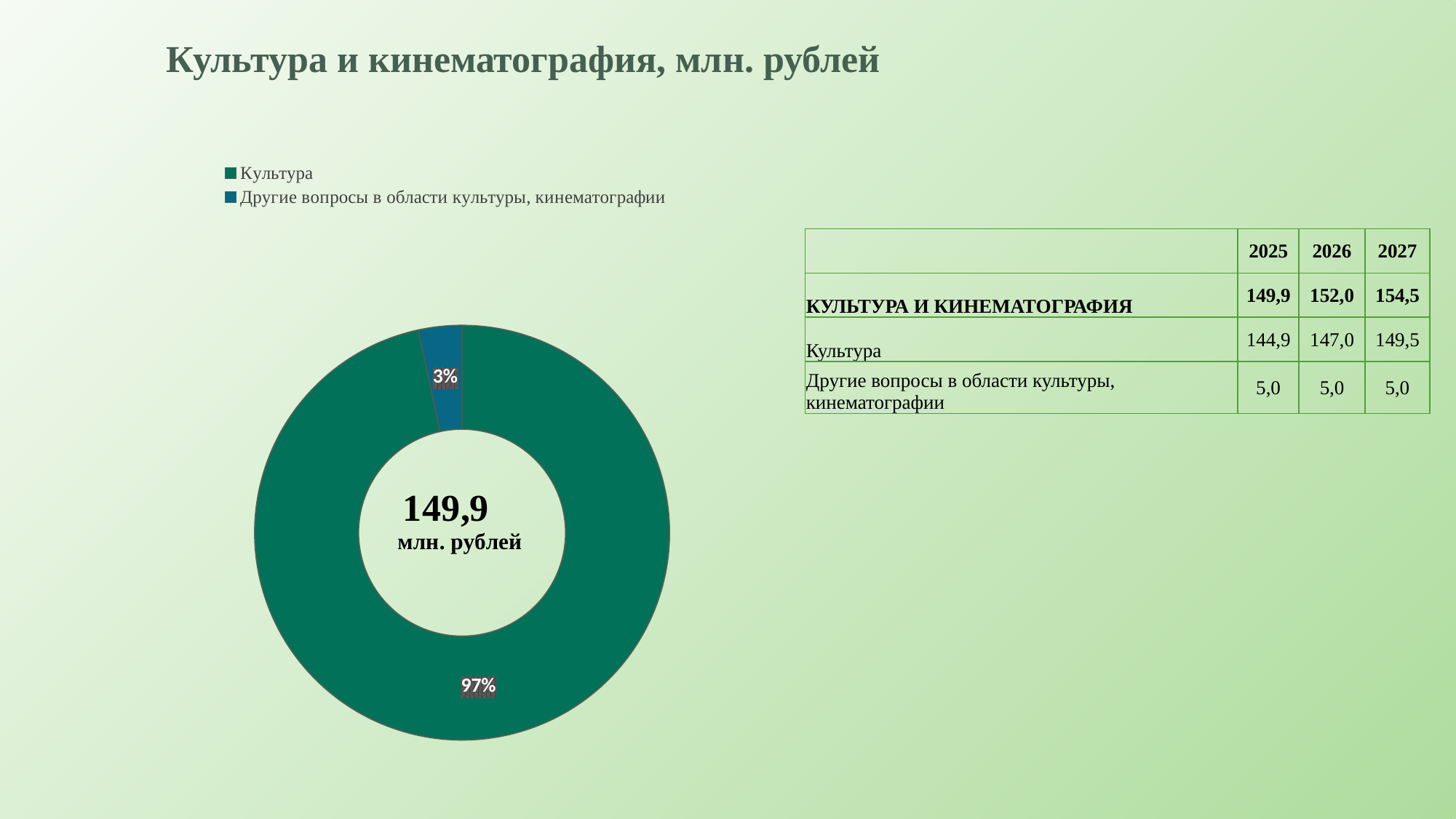
How many slices does the doughnut chart have? 2 What share of the doughnut chart does the slice for Другие вопросы в области культуры, кинематографии represent? 3% Which category has the smallest slice in the doughnut chart? Другие вопросы в области культуры, кинематографии What total value is printed in the centre of the doughnut chart? 149,9 млн. рублей What kind of chart is shown on the slide? Doughnut (pie) chart Which slice is larger: Культура or Другие вопросы в области культуры, кинематографии? Культура What share of the doughnut chart does the Культура slice represent? 97% Which category has the largest slice in the doughnut chart? Культура How many entries does the chart legend list? 2 What is the difference in percentage points between the Культура slice and the Другие вопросы в области культуры, кинематографии slice? 94 percentage points What is the title of the slide containing the doughnut chart? Культура и кинематография, млн. рублей